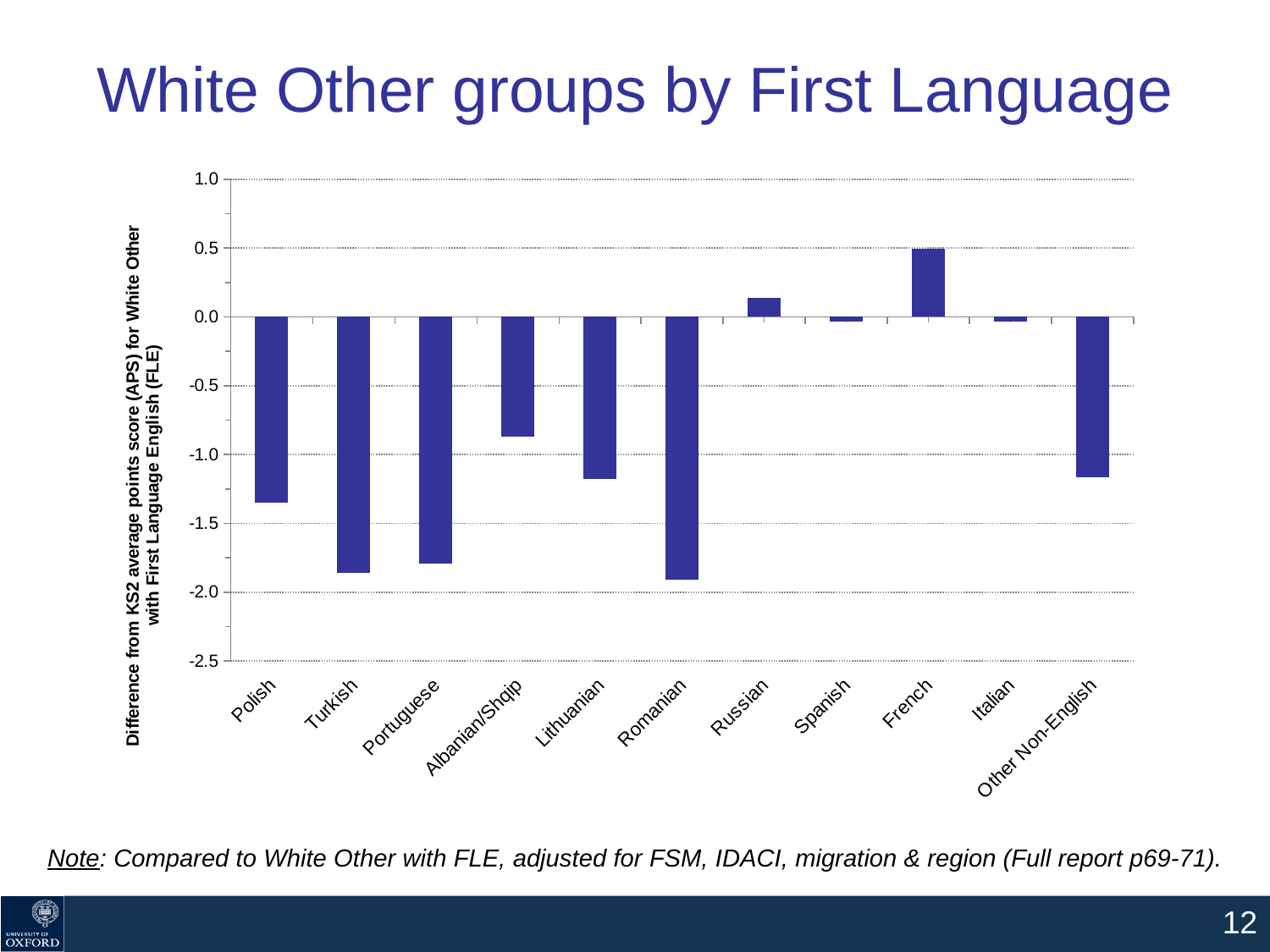
Which has the larger value, Polish or Albanian/Shqip? Albanian/Shqip How many first-language groups are shown on the x axis? 11 What is the title of the slide containing the chart? White Other groups by First Language What kind of chart is shown on the slide? bar chart Is the value for Russian greater or less than 0.5? less Which has the larger value, Turkish or Polish? Polish Is the value for Polish greater or less than -1.0? less Which first-language group has the highest value? French Which has the larger value, French or Russian? French Is the value for French greater or less than 0.0? greater